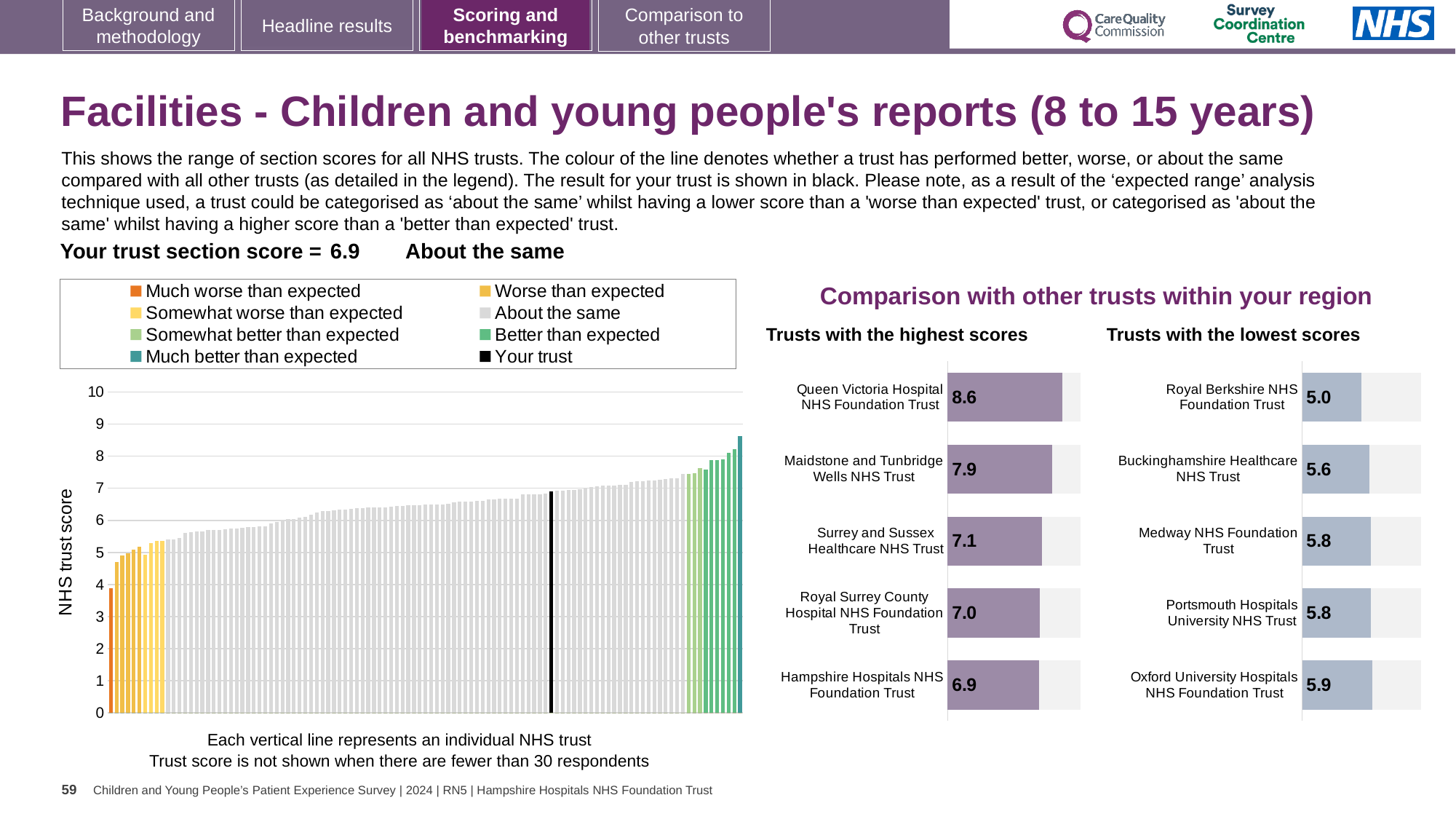
In the 'NHS trust score' chart on the left, do the bar values rise or fall from left to right? Rise In the 'Trusts with the lowest scores' chart, which trust has the highest score shown? Oxford University Hospitals NHS Foundation Trust In the 'NHS trust score' chart on the left, is the value of the tallest bar greater or less than 8? greater In the 'Trusts with the highest scores' chart, what is the difference between the scores of Queen Victoria Hospital NHS Foundation Trust and Maidstone and Tunbridge Wells NHS Trust? 0.7 In the 'Trusts with the lowest scores' chart, which has the larger score: Buckinghamshire Healthcare NHS Trust or Oxford University Hospitals NHS Foundation Trust? Oxford University Hospitals NHS Foundation Trust In the 'Trusts with the highest scores' chart, what is the score for Queen Victoria Hospital NHS Foundation Trust? 8.6 In the 'Trusts with the highest scores' chart, which trust has the lowest score shown? Hampshire Hospitals NHS Foundation Trust In the 'Trusts with the lowest scores' chart, what is the score for Medway NHS Foundation Trust? 5.8 How many trusts are listed in the 'Trusts with the highest scores' chart? 5 What kind of chart is the 'NHS trust score' chart on the left of the slide? Bar chart How many entries does the legend of the 'NHS trust score' chart on the left list? 8 In the 'Trusts with the lowest scores' chart, what is the score for Royal Berkshire NHS Foundation Trust? 5.0